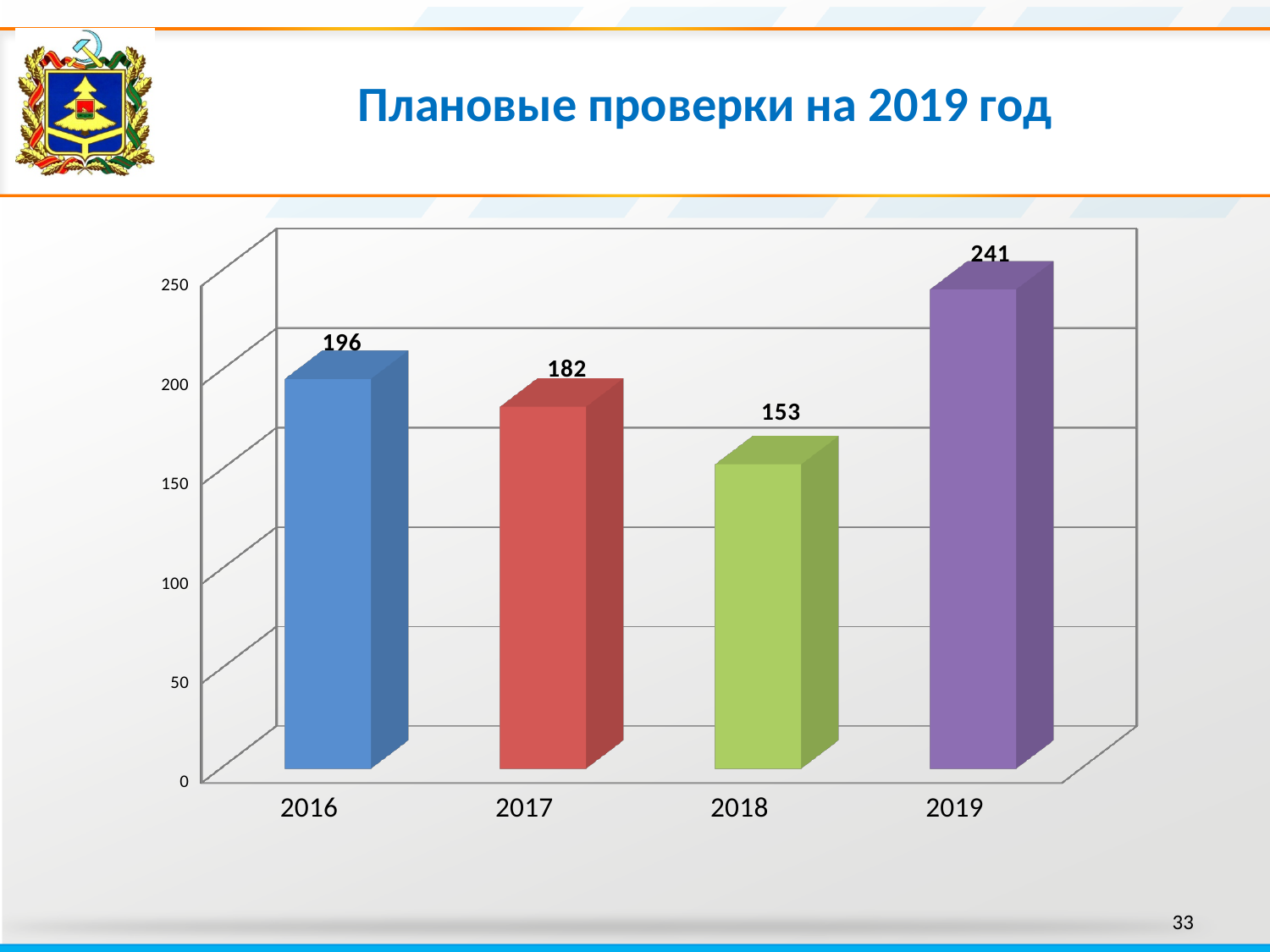
What is the value for 2019? 241 What is the value for 2016? 196 What is the value for 2017? 182 How many years are shown on the x axis? 4 What is the title of the slide? Плановые проверки на 2019 год Which year has the lowest value? 2018 Which is larger, the value for 2016 or the value for 2017? 2016 What is the difference between the values for 2019 and 2018? 88 What is the value for 2018? 153 What kind of chart is shown on the slide? bar chart Which year has the highest value? 2019 What is the difference between the values for 2016 and 2017? 14